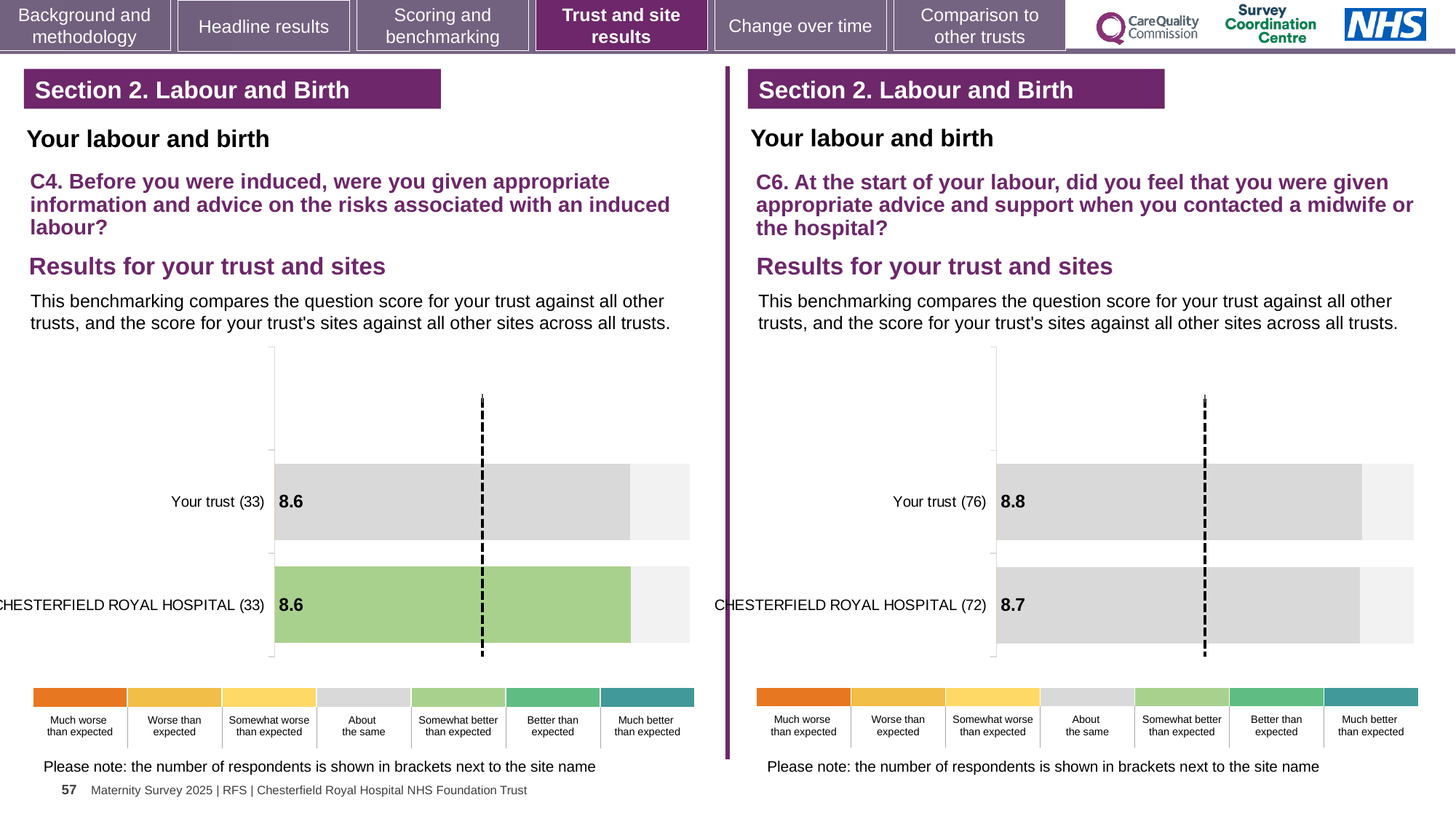
What type of chart is used for the C4 results on the left? Bar chart In the right chart (C6), what is the difference between the score for Your trust (76) and the score for CHESTERFIELD ROYAL HOSPITAL (72)? 0.1 In the left chart (C4), what is the score for CHESTERFIELD ROYAL HOSPITAL (33)? 8.6 In the left chart (C4), what is the score for Your trust (33)? 8.6 In the right chart (C6), which has the higher score: Your trust (76) or CHESTERFIELD ROYAL HOSPITAL (72)? Your trust (76) How many bars are plotted in the right chart (C6)? 2 In the left chart (C4), which benchmark category does the colour of the CHESTERFIELD ROYAL HOSPITAL (33) bar correspond to in the legend? Somewhat better than expected In the right chart (C6), which benchmark category does the colour of the Your trust (76) bar correspond to in the legend? About the same In the left chart (C4), what is the difference between the score for Your trust (33) and the score for CHESTERFIELD ROYAL HOSPITAL (33)? 0 How many bars are plotted in the left chart (C4)? 2 In the right chart (C6), what is the score for CHESTERFIELD ROYAL HOSPITAL (72)? 8.7 In the right chart (C6), what is the score for Your trust (76)? 8.8